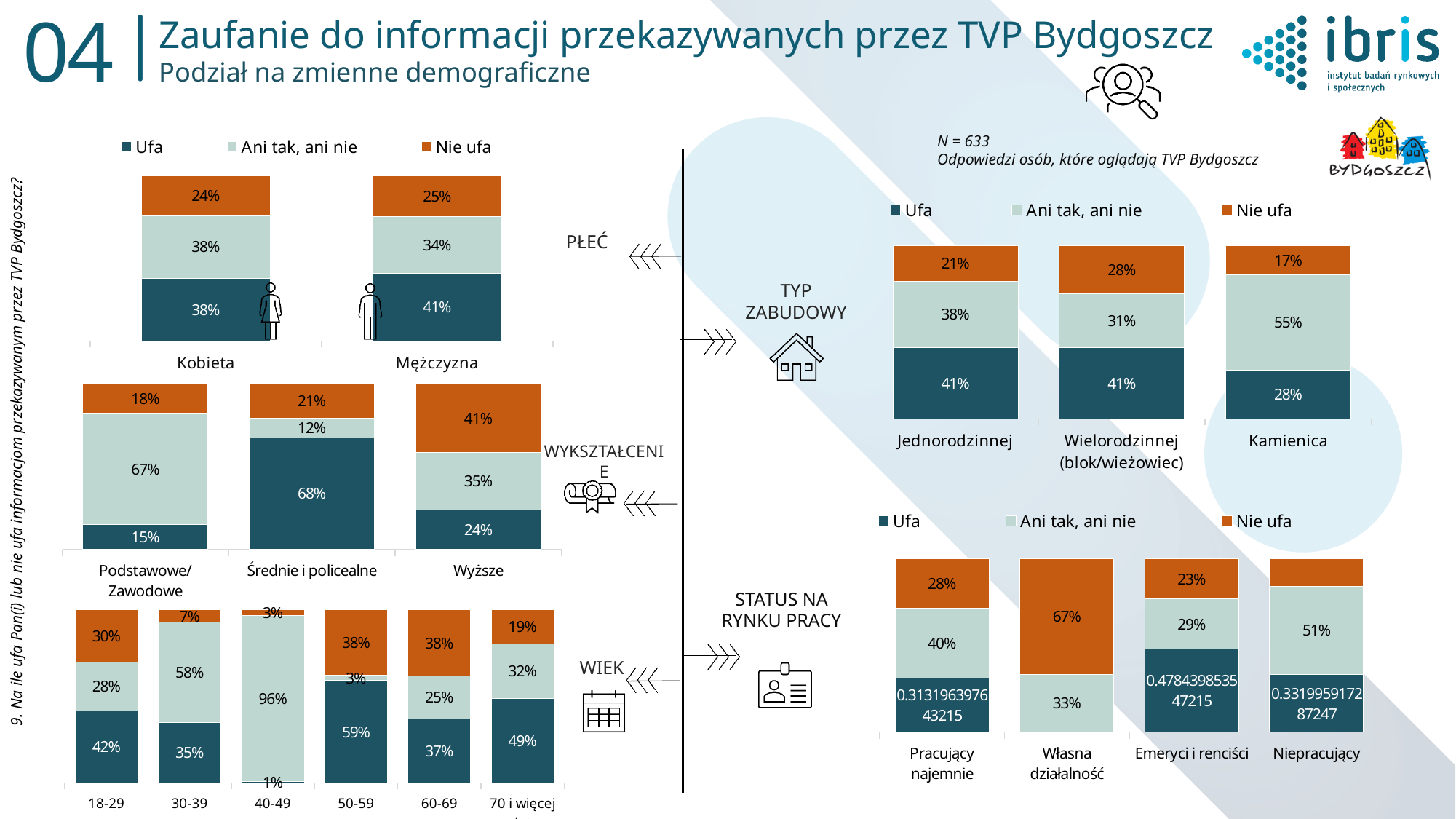
In the TYP ZABUDOWY chart, which housing type has the lowest 'Nie ufa' share? Kamienica In the PŁEĆ chart, what is the 'Nie ufa' value for Mężczyzna? 25% In the PŁEĆ chart, what percentage of women (Kobieta) answered 'Ufa'? 38% In the WYKSZTAŁCENIE chart, what is the 'Nie ufa' value for Wyższe? 41% In the TYP ZABUDOWY chart, what is the 'Ani tak, ani nie' value for Kamienica? 55% How many series does the legend of the PŁEĆ chart list? 3 In the WIEK chart, how many age categories are shown? 6 In the WIEK chart, what is the 'Ufa' value for the 50-59 age group? 59% In the WYKSZTAŁCENIE chart, which education group has the highest 'Ufa' share? Średnie i policealne In the WIEK chart, which age group has the highest 'Ani tak, ani nie' share? 40-49 In the STATUS NA RYNKU PRACY chart, what is the 'Nie ufa' value for Własna działalność? 67% In the WYKSZTAŁCENIE chart, what is the difference between the 'Ani tak, ani nie' values for Podstawowe/Zawodowe and Wyższe? 32 percentage points